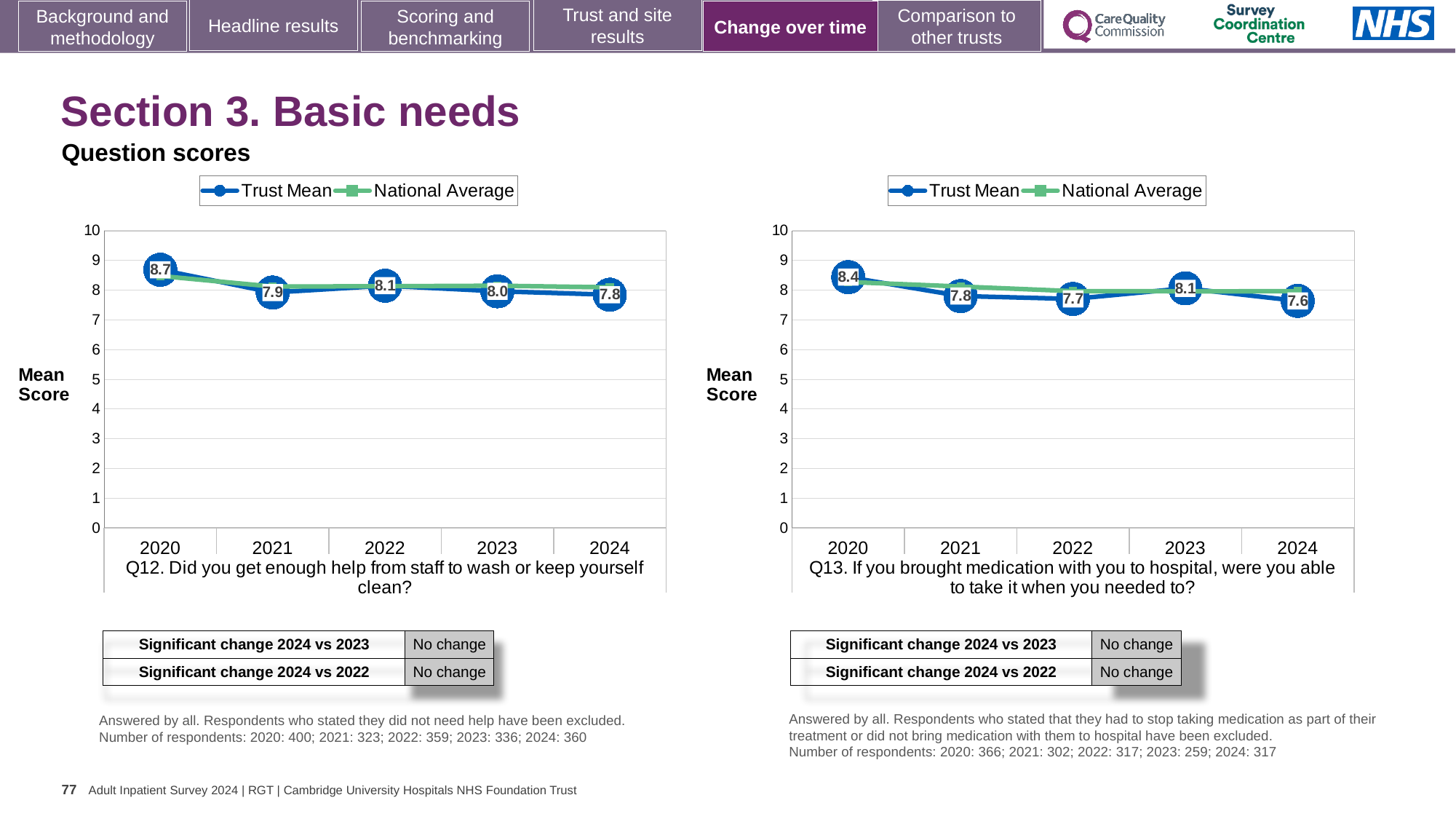
How many years are plotted on the x axis of the Q12 chart (left)? 5 In the Q13 chart (right), what is the Trust Mean score for 2023? 8.1 In the Q12 chart (left), what is the Trust Mean score for 2024? 7.8 In the Q12 chart (left), does the Trust Mean score rise or fall from 2020 to 2021? Fall In the Q13 chart (right), which year has the highest Trust Mean score? 2020 How many series does the legend of the Q13 chart (right) list? 2 What type of chart is used for Q12 (left)? Line chart In the Q12 chart (left), what is the difference between the Trust Mean scores for 2020 and 2024? 0.9 In the Q12 chart (left), is the National Average for 2022 greater or less than 7? greater In the Q13 chart (right), which year has the lowest Trust Mean score? 2024 In the Q13 chart (right), which is larger, the Trust Mean score for 2021 or for 2023? 2023 In the Q12 chart (left), what is the Trust Mean score for 2020? 8.7